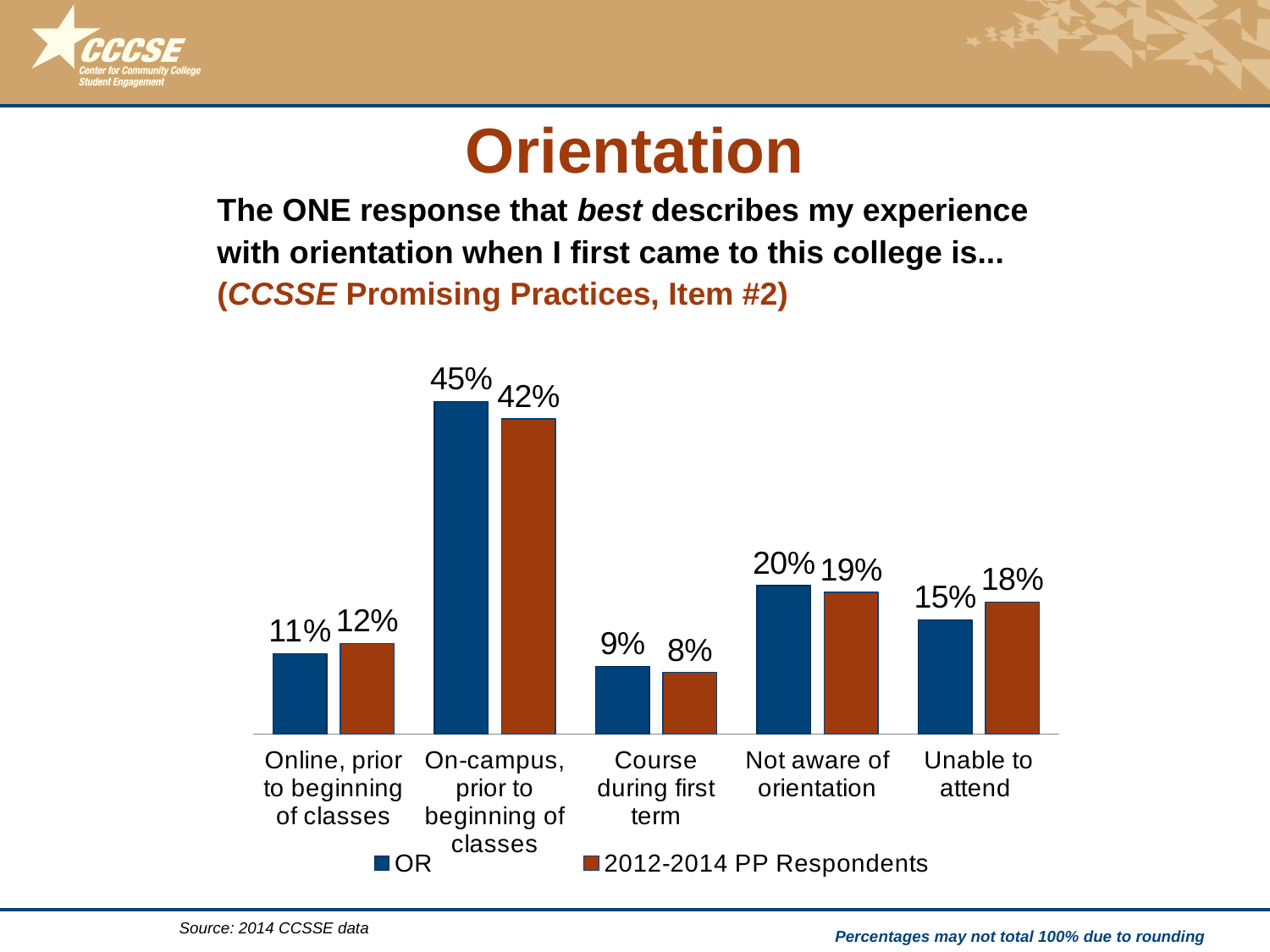
Which is larger for 'Unable to attend': the OR value or the 2012-2014 PP Respondents value? 2012-2014 PP Respondents What is the OR value for 'On-campus, prior to beginning of classes'? 45% Which category has the lowest 2012-2014 PP Respondents value? Course during first term Which is larger for 'Not aware of orientation': the OR value or the 2012-2014 PP Respondents value? OR How many categories are shown on the x axis? 5 What kind of chart is shown on the slide? Bar chart What colour are the bars for the OR series? Blue What is the 2012-2014 PP Respondents value for 'Unable to attend'? 18% Which category has the highest OR value? On-campus, prior to beginning of classes What is the difference between the OR and 2012-2014 PP Respondents values for 'On-campus, prior to beginning of classes'? 3% What is the OR value for 'Course during first term'? 9% How many series does the legend list? 2